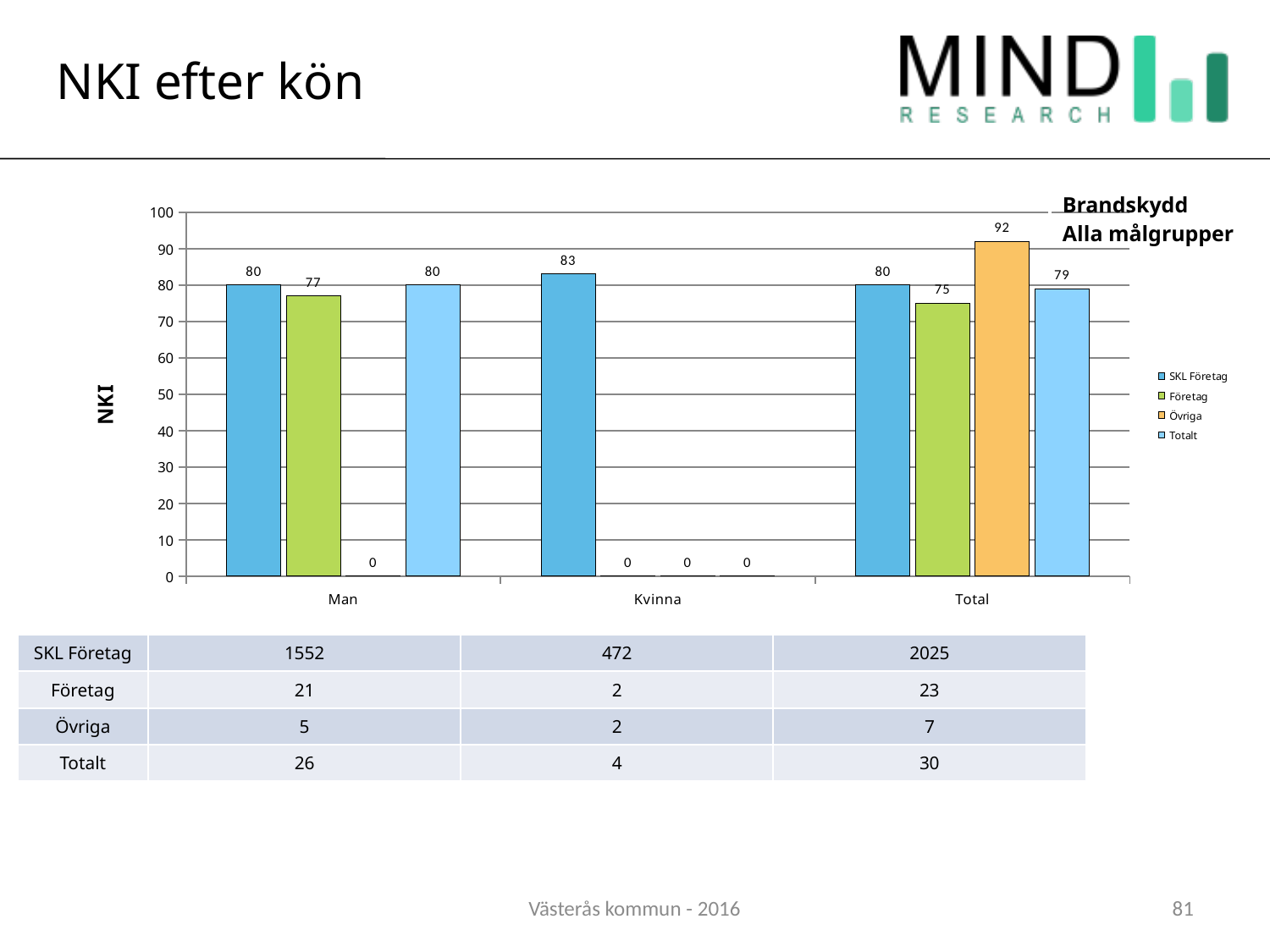
What is the label on the vertical axis of the chart? NKI Which series has the lowest non-zero value in the Total category? Företag How many categories are shown on the x axis? 3 How many series does the legend list? 4 What is the NKI value for SKL Företag in the Kvinna category? 83 What kind of chart is shown on the slide? Bar chart What is the NKI value for Övriga in the Total category? 92 Which series has the highest value in the Total category? Övriga What is the NKI value for Företag in the Man category? 77 What is the NKI value for Totalt in the Total category? 79 What is the difference between the Övriga value and the Företag value in the Total category? 17 Which is larger: the SKL Företag value for Kvinna or the SKL Företag value for Man? Kvinna